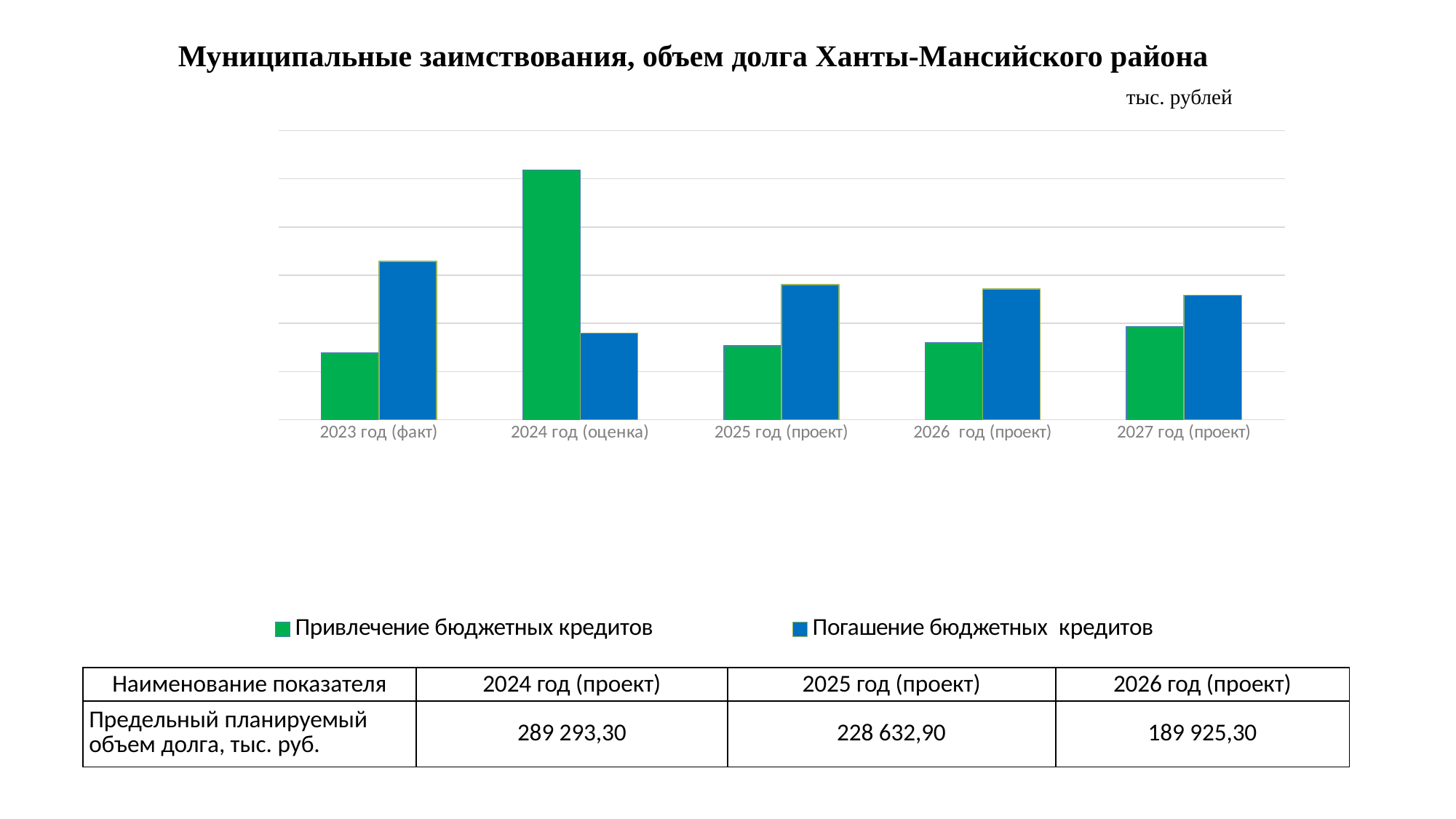
What kind of chart is shown on the slide? bar chart In 2023 год (факт), which is larger: Привлечение бюджетных кредитов or Погашение бюджетных кредитов? Погашение бюджетных кредитов What is the title of the chart? Муниципальные заимствования, объем долга Ханты-Мансийского района How many year categories are shown on the x axis of the chart? 5 In which year is the value for Погашение бюджетных кредитов the highest? 2023 год (факт) In 2024 год (оценка), which is larger: Привлечение бюджетных кредитов or Погашение бюджетных кредитов? Привлечение бюджетных кредитов In 2027 год (проект), which is larger: Привлечение бюджетных кредитов or Погашение бюджетных кредитов? Погашение бюджетных кредитов Which colour represents Погашение бюджетных кредитов in the chart? blue In which year is the value for Погашение бюджетных кредитов the lowest? 2024 год (оценка) How many series does the chart legend list? 2 In which year is the value for Привлечение бюджетных кредитов the highest? 2024 год (оценка)